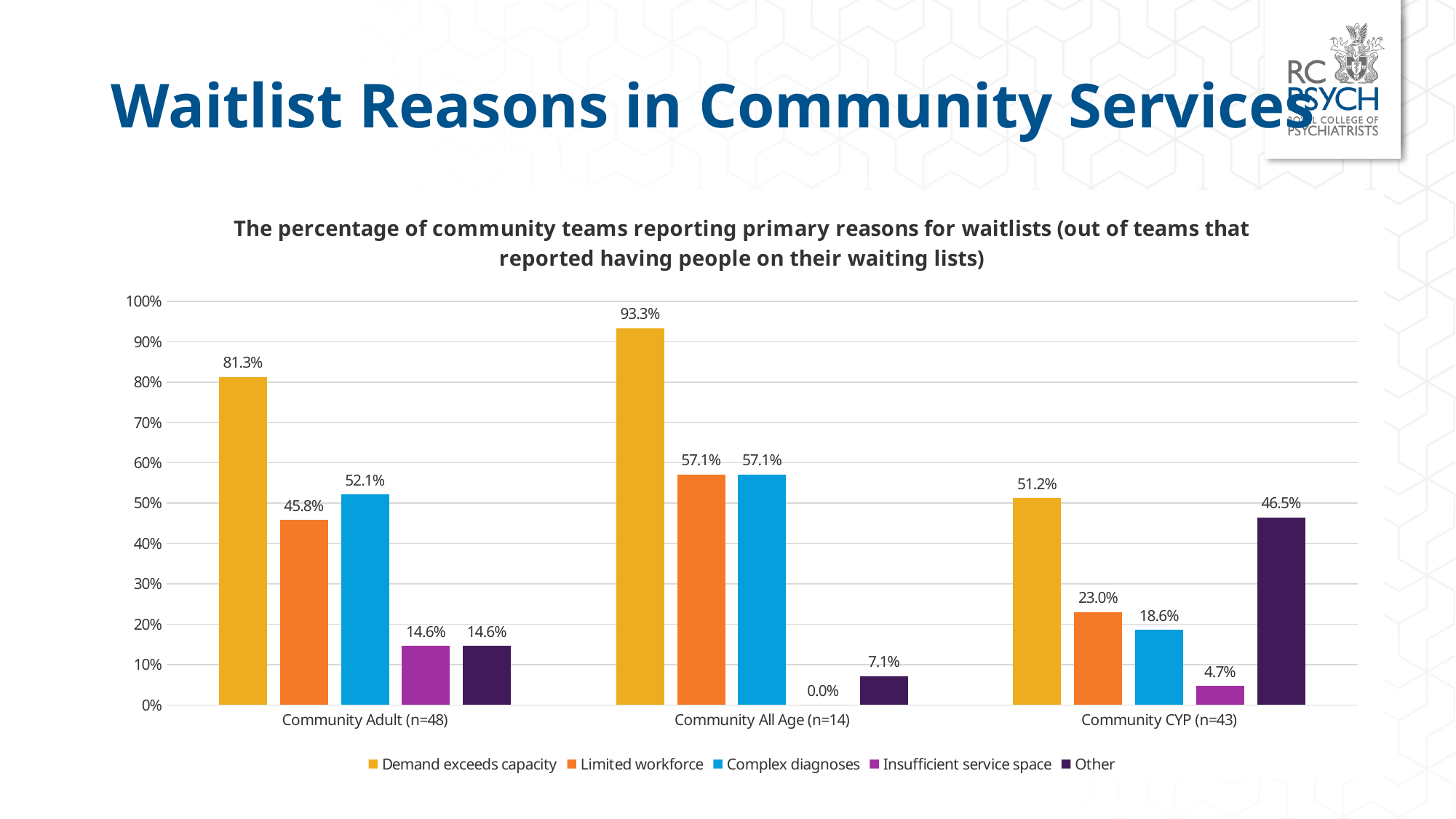
What is the difference between the Demand exceeds capacity values for Community All Age (n=14) and Community Adult (n=48)? 12.0% Which series is shown in orange in the legend? Limited workforce What percentage of Community Adult (n=48) teams reported Demand exceeds capacity as a primary reason for waitlists? 81.3% How many groups are shown on the x axis? 3 What is the value for Insufficient service space in the Community All Age (n=14) group? 0.0% Which is larger in the Community Adult (n=48) group: Limited workforce or Complex diagnoses? Complex diagnoses What is the value for Other in the Community CYP (n=43) group? 46.5% Which reason has the lowest value in the Community CYP (n=43) group? Insufficient service space Which group has the highest value for Demand exceeds capacity? Community All Age (n=14) What is the value for Limited workforce in the Community CYP (n=43) group? 23.0% How many series does the legend list? 5 What kind of chart is shown on the slide? Bar chart